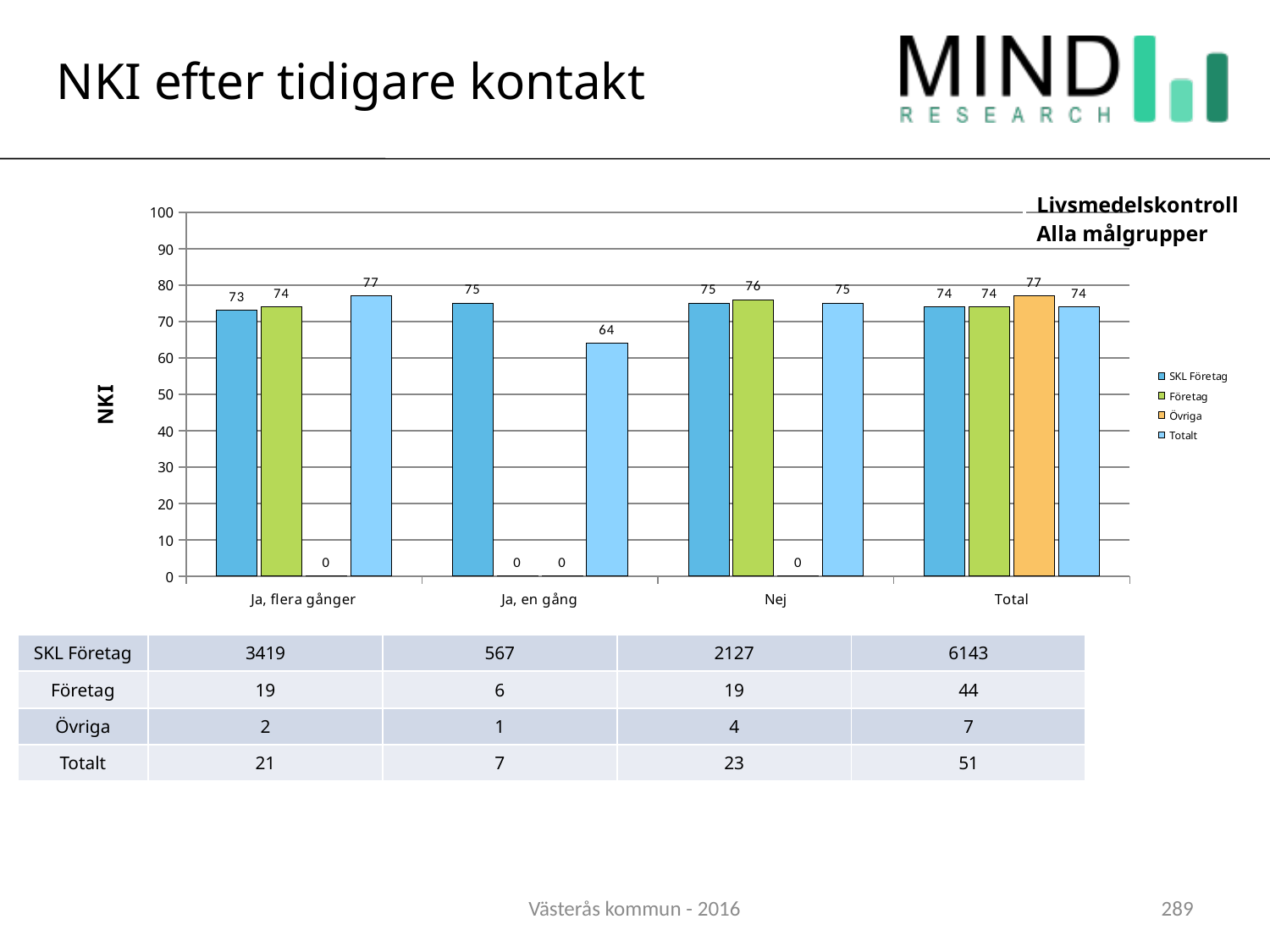
How many series does the legend list? 4 What kind of chart is shown on the slide? Bar chart What is the NKI value for Totalt in the 'Ja, en gång' category? 64 What is the label of the y axis? NKI Which category has the lowest Totalt value? Ja, en gång What is the NKI value for Företag in the 'Nej' category? 76 What is the NKI value for Övriga in the 'Total' category? 77 Which series is shown in orange in the legend? Övriga What is the NKI value for SKL Företag in the 'Ja, flera gånger' category? 73 How many categories are shown on the x axis? 4 What is the difference between the Totalt value for 'Ja, flera gånger' and the Totalt value for 'Ja, en gång'? 13 Which is larger: the SKL Företag value for 'Ja, en gång' or the Totalt value for 'Ja, en gång'? SKL Företag